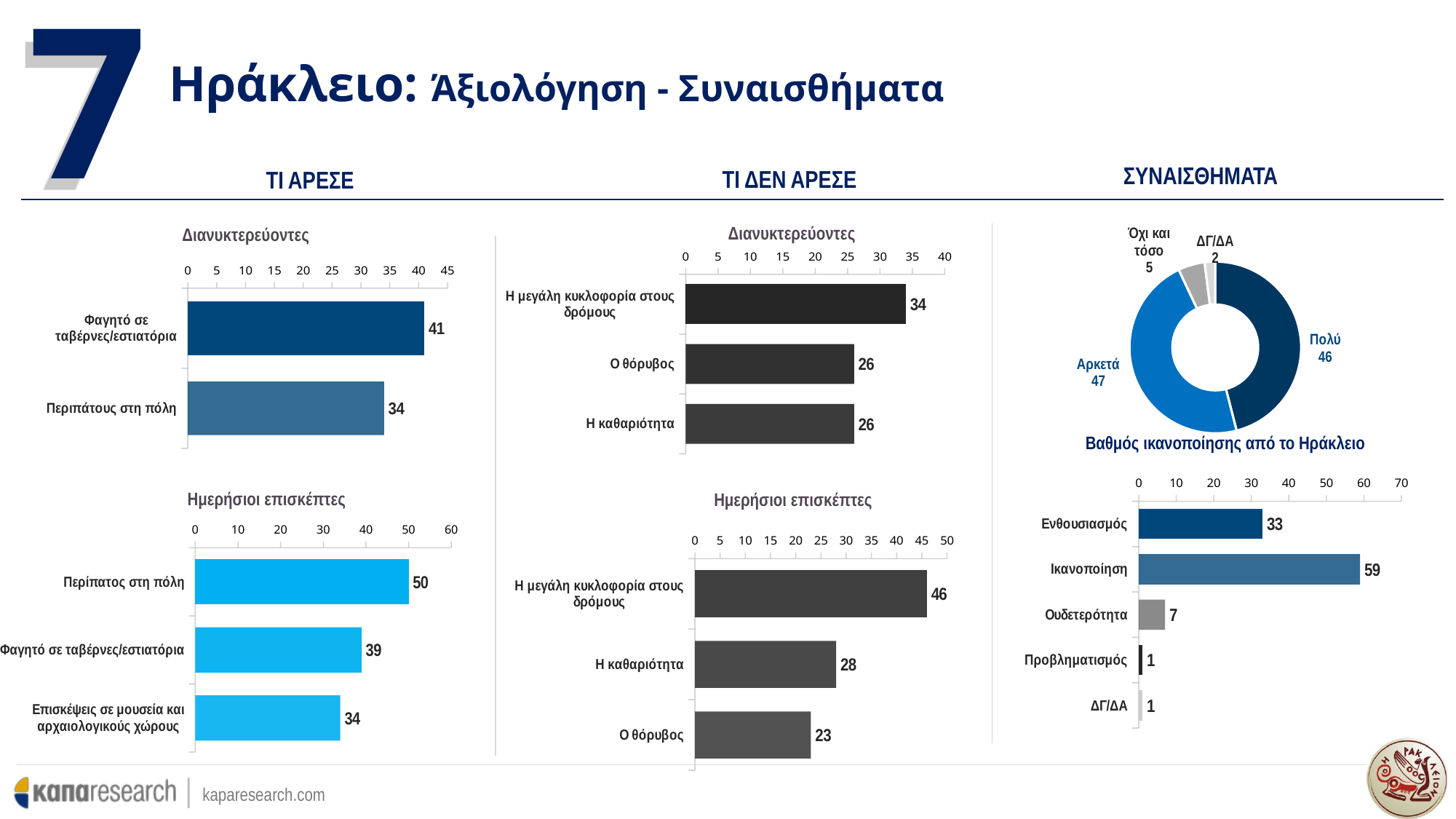
What kind of chart is 'Βαθμός ικανοποίησης από το Ηράκλειο'? Donut chart In the 'ΤΙ ΑΡΕΣΕ' chart for Διανυκτερεύοντες (top left), what is the value for 'Φαγητό σε ταβέρνες/εστιατόρια'? 41 In the 'ΤΙ ΔΕΝ ΑΡΕΣΕ' chart for Ημερήσιοι επισκέπτες (bottom middle), is the value for 'Η μεγάλη κυκλοφορία στους δρόμους' larger than the value for 'Η καθαριότητα'? Yes In the ΣΥΝΑΙΣΘΗΜΑΤΑ bar chart (bottom right), what is the value for 'Ικανοποίηση'? 59 In the ΣΥΝΑΙΣΘΗΜΑΤΑ bar chart (bottom right), what is the difference between 'Ικανοποίηση' and 'Ενθουσιασμός'? 26 In the donut chart 'Βαθμός ικανοποίησης από το Ηράκλειο', what is the value for 'Αρκετά'? 47 In the 'ΤΙ ΔΕΝ ΑΡΕΣΕ' chart for Ημερήσιοι επισκέπτες (bottom middle), how many categories are shown? 3 In the 'ΤΙ ΔΕΝ ΑΡΕΣΕ' chart for Ημερήσιοι επισκέπτες (bottom middle), which category has the lowest value? Ο θόρυβος In the 'ΤΙ ΑΡΕΣΕ' chart for Ημερήσιοι επισκέπτες (bottom left), what is the difference between 'Περίπατος στη πόλη' and 'Επισκέψεις σε μουσεία και αρχαιολογικούς χώρους'? 16 In the 'ΤΙ ΔΕΝ ΑΡΕΣΕ' chart for Διανυκτερεύοντες (top middle), what is the value for 'Ο θόρυβος'? 26 In the 'ΤΙ ΑΡΕΣΕ' chart for Ημερήσιοι επισκέπτες (bottom left), which category has the highest value? Περίπατος στη πόλη In the donut chart 'Βαθμός ικανοποίησης από το Ηράκλειο', which category has the smallest value? ΔΓ/ΔΑ